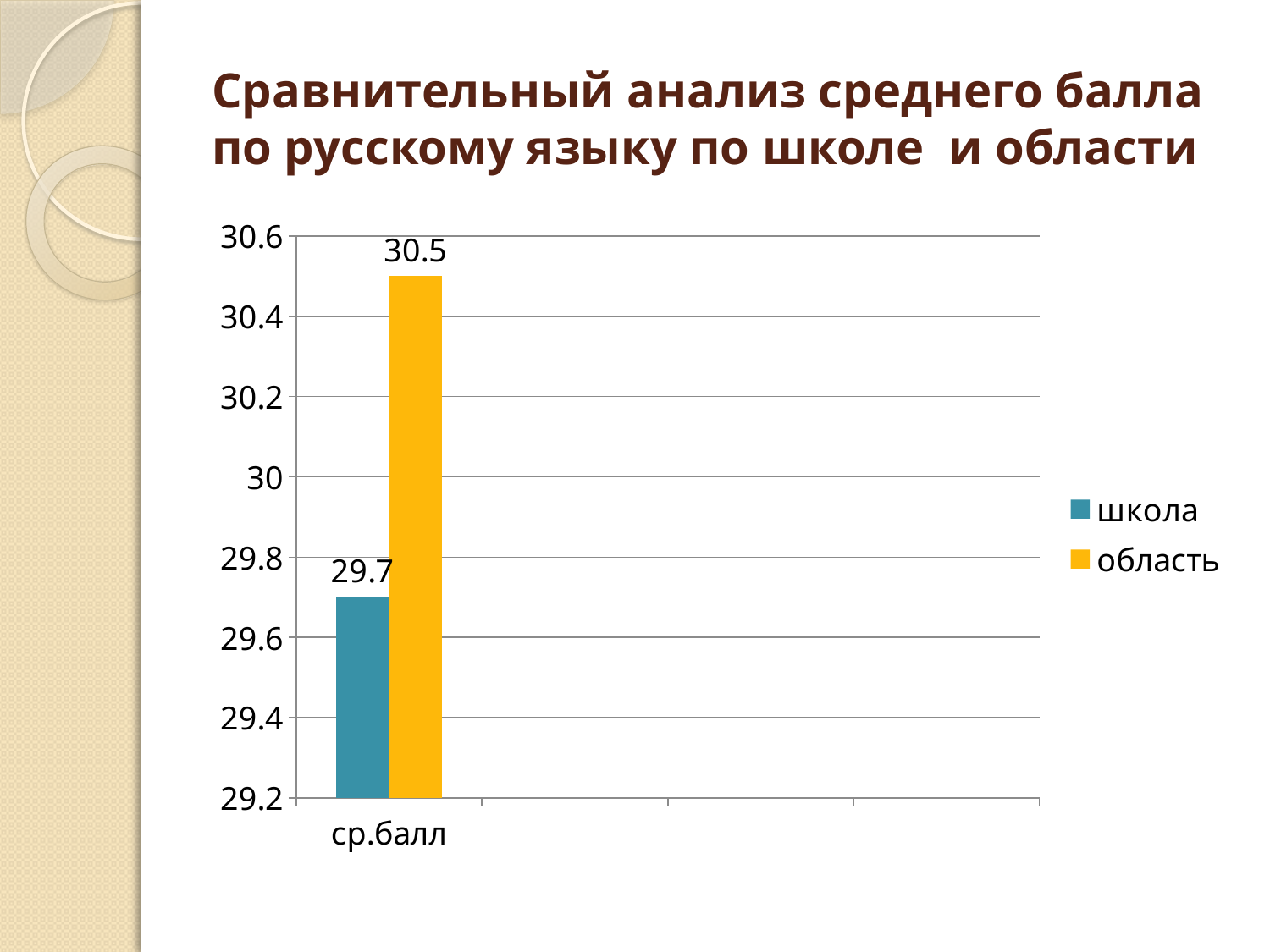
Is the value for область greater or less than 30.4? greater How many categories are shown on the x axis? 1 Which series is shown in yellow? область What kind of chart is shown on the slide? bar chart What is the value for школа in the ср.балл category? 29.7 How many series does the legend list? 2 Which series has the higher value: школа or область? область What is the difference between the область value and the школа value? 0.8 What is the label of the category on the x axis? ср.балл Is the value for школа greater or less than 30? less What is the value for область in the ср.балл category? 30.5 Which series has the lowest value on the chart? школа